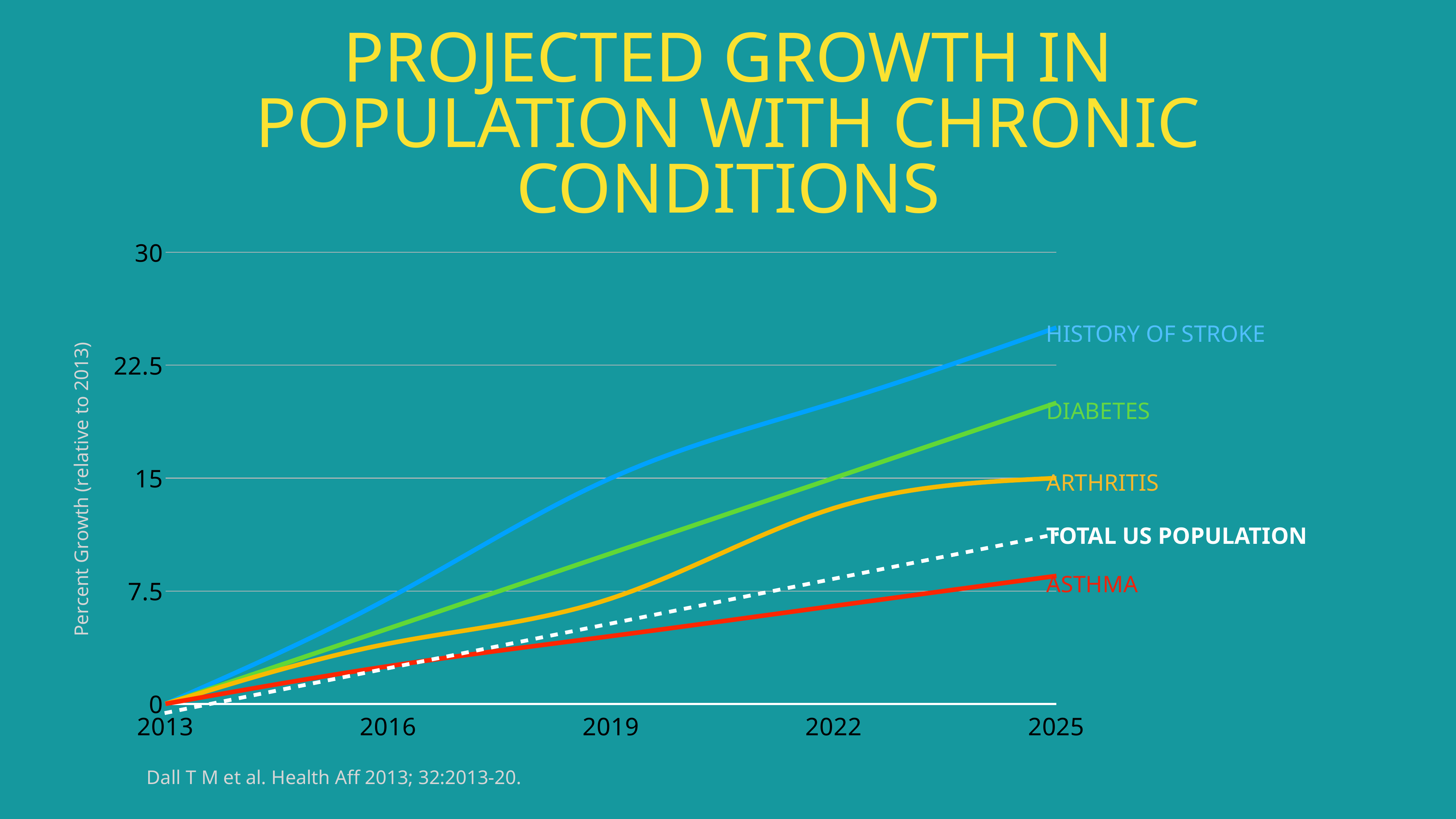
Do the values for History of Stroke rise or fall from 2013 to 2025? rise How many series are labelled on the chart? 5 Which series has the lowest value in 2025? Asthma How many years are labelled on the x axis? 5 What is the label on the y axis? Percent Growth (relative to 2013) Is the value for Diabetes in 2025 greater or less than 22.5? less Is the value for Asthma in 2019 greater or less than 7.5? less Which series has the highest value in 2025? History of Stroke What kind of chart is shown on the slide? line chart Is the value for History of Stroke in 2025 greater or less than 22.5? greater In 2025, which is larger, Diabetes or Arthritis? Diabetes